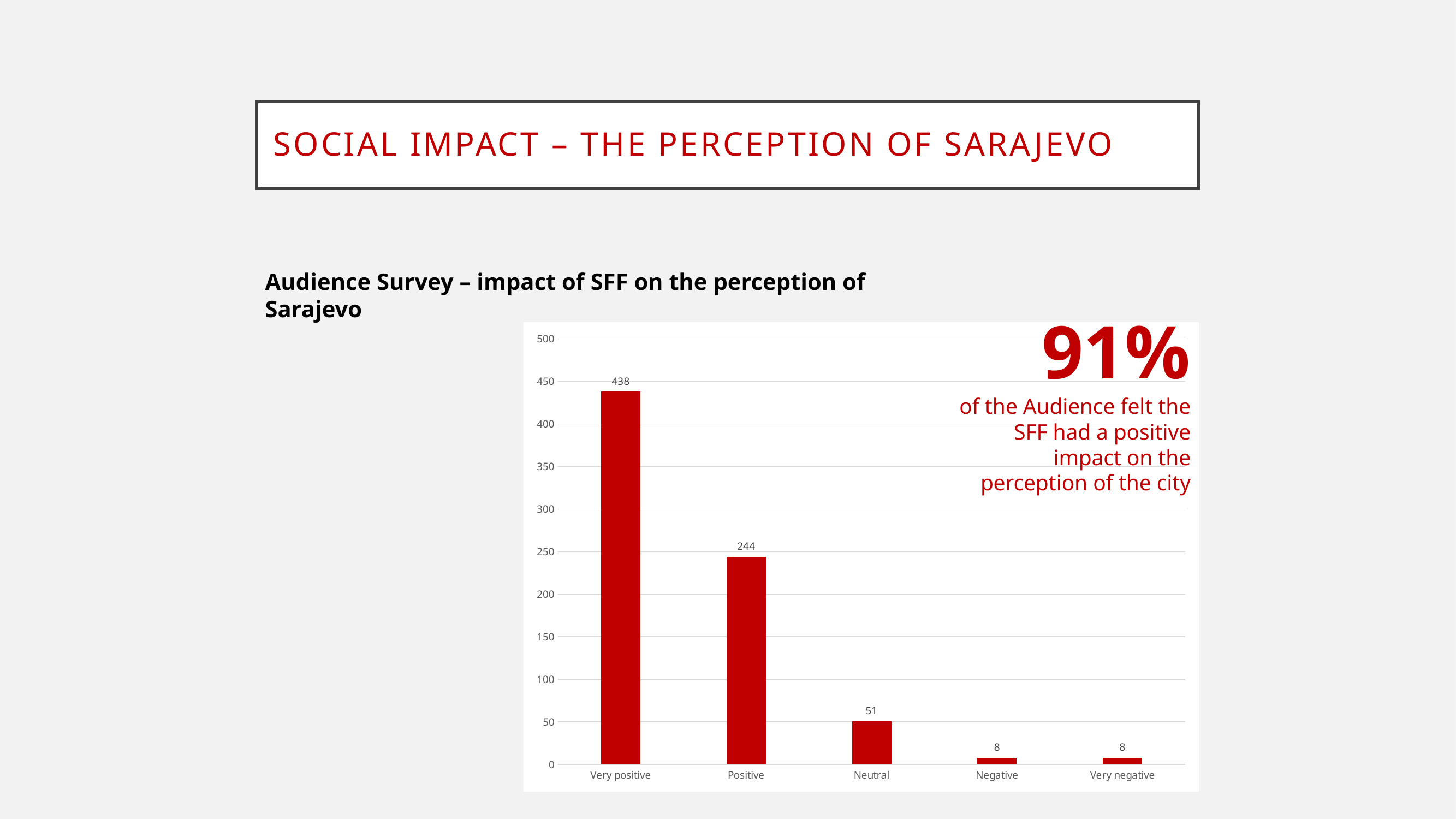
What percentage of the audience felt the SFF had a positive impact on the perception of the city, according to the text next to the chart? 91% Is the value for Very positive greater or less than 400? greater Which is larger, the value for Positive or the value for Neutral? Positive What is the value for Neutral? 51 What kind of chart is shown on the slide? bar chart What is the difference between the values for Very positive and Positive? 194 What is the value for Very positive? 438 What is the value for Positive? 244 What is the value for Negative? 8 Which category has the highest value? Very positive How many categories are shown on the x axis? 5 Do the values rise or fall from Very positive to Very negative along the x axis? fall